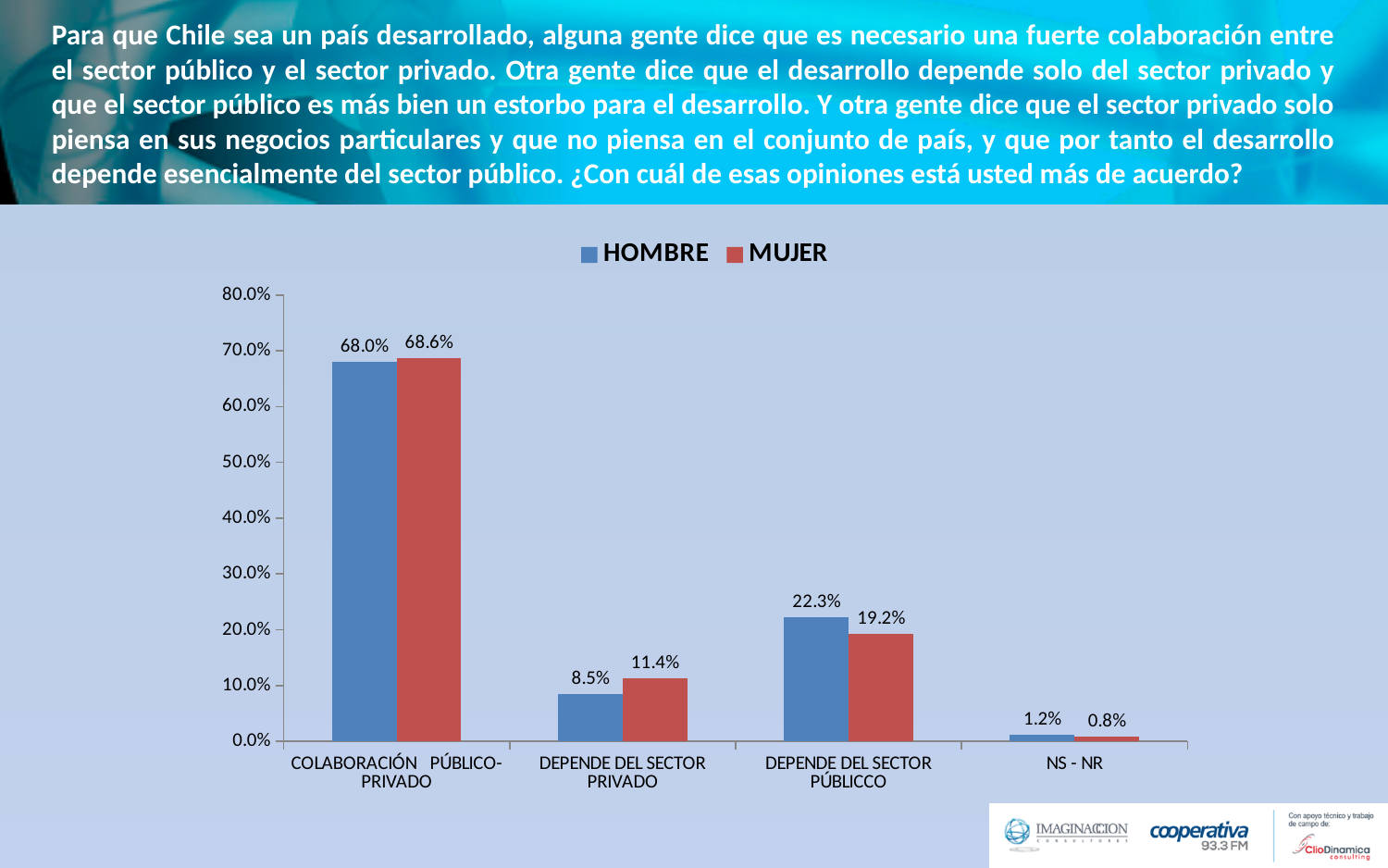
Which category has the lowest HOMBRE value? NS - NR What is the difference between the MUJER and HOMBRE values for DEPENDE DEL SECTOR PRIVADO? 2.9% What kind of chart is shown on the slide? bar chart Which category has the highest MUJER value? COLABORACIÓN PÚBLICO-PRIVADO What is the MUJER value for NS - NR? 0.8% What is the HOMBRE value for COLABORACIÓN PÚBLICO-PRIVADO? 68.0% How many series does the legend list? 2 For DEPENDE DEL SECTOR PÚBLICCO, which series has the larger value, HOMBRE or MUJER? HOMBRE How many categories are shown on the x axis? 4 What is the HOMBRE value for DEPENDE DEL SECTOR PÚBLICCO? 22.3% What is the MUJER value for DEPENDE DEL SECTOR PRIVADO? 11.4% Is the HOMBRE value for DEPENDE DEL SECTOR PÚBLICCO greater or less than 20.0%? greater